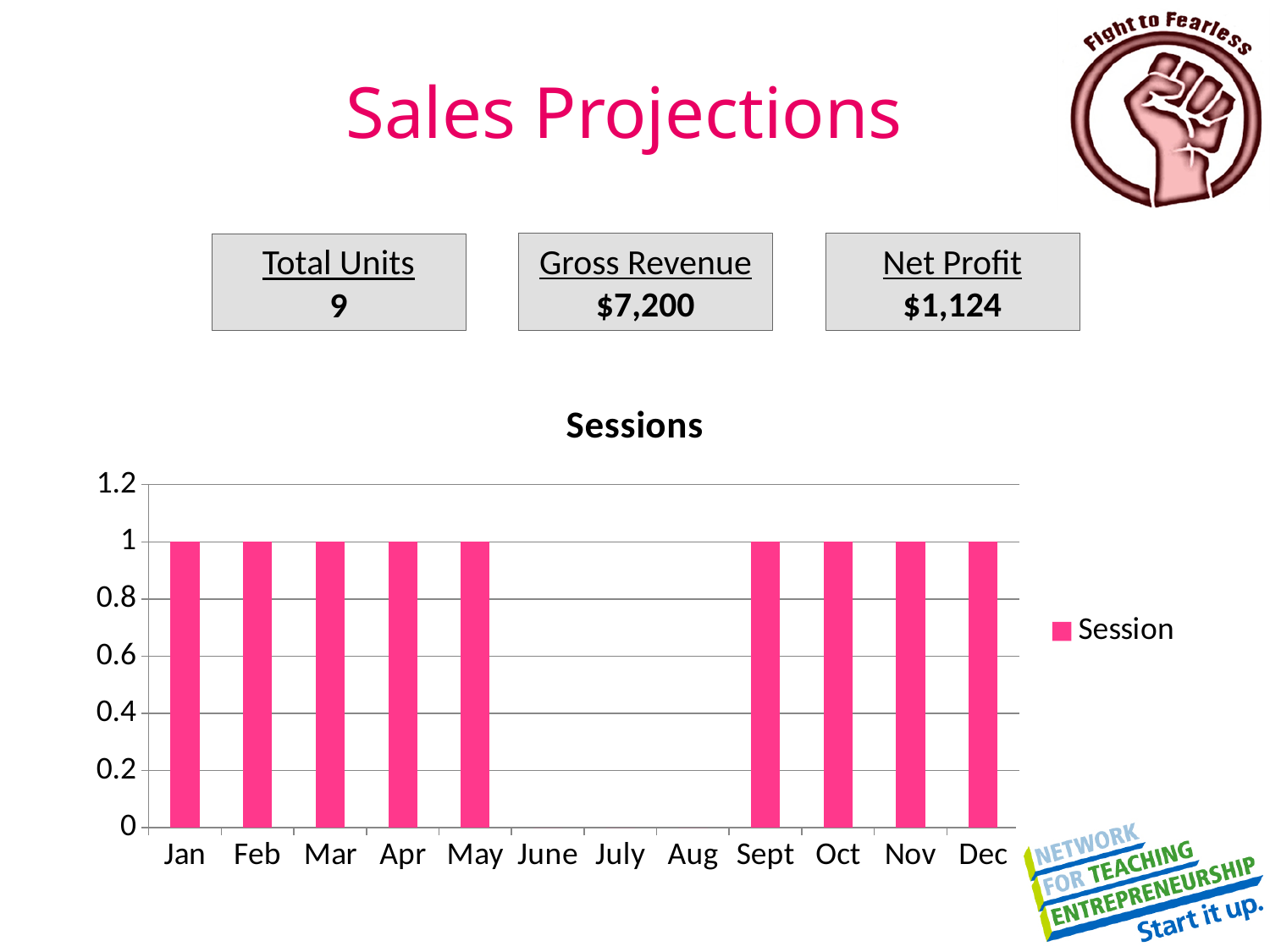
How many months are shown on the x axis of the chart? 12 What is the value for June in the Sessions chart? 0 What is the difference between the value for Jan and the value for July? 1 What is the value for Jan in the Sessions chart? 1 How many series does the chart legend list? 1 How many months have a value of 0 in the Sessions chart? 3 What kind of chart is shown on the slide? bar chart What is the value for Dec in the Sessions chart? 1 What is the title of the chart? Sessions What is the name of the series shown in the legend? Session Is the value for Mar greater or less than 0.6? greater Which is larger, the value for Feb or the value for July? Feb